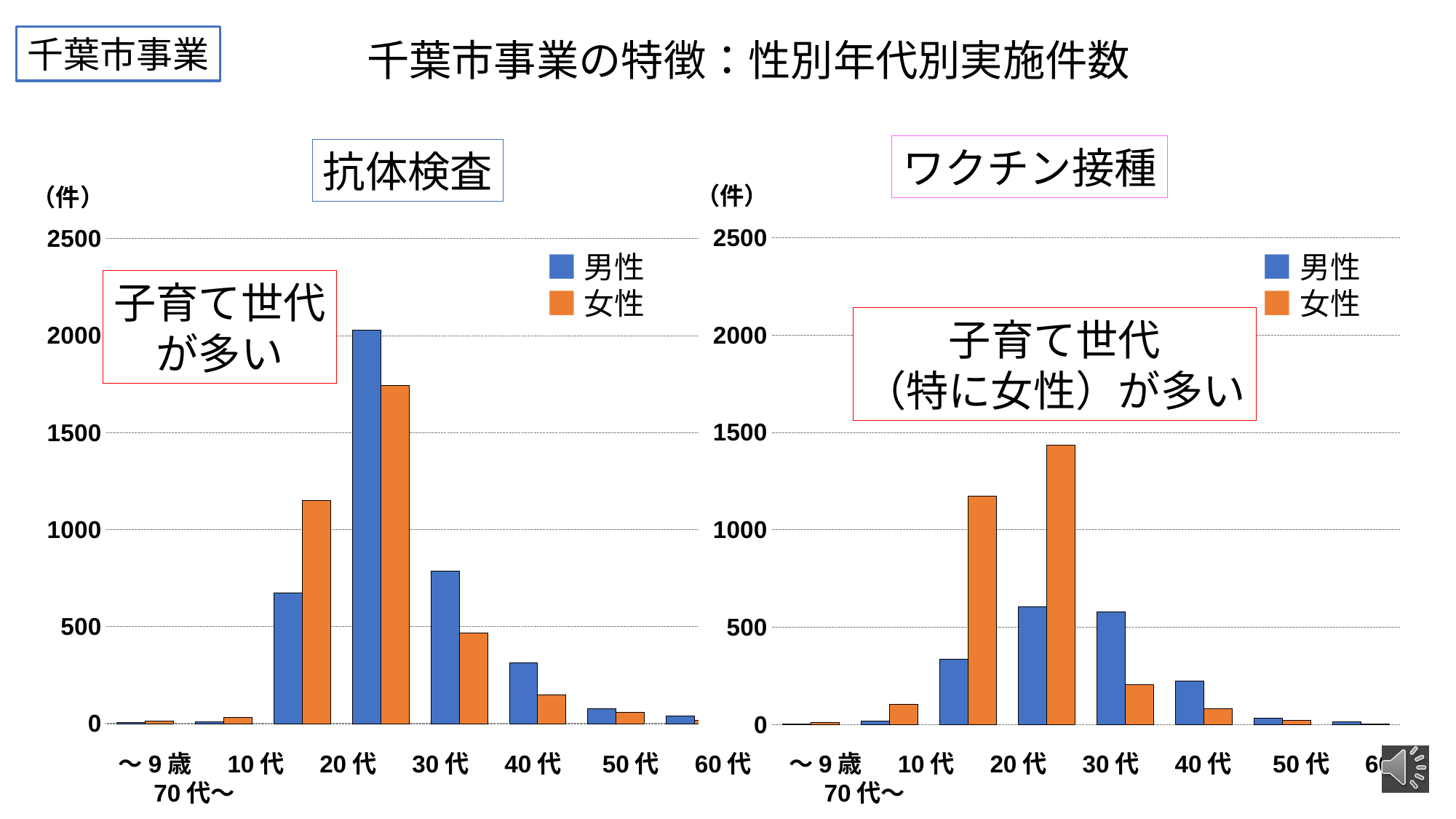
What kind of chart is the 抗体検査 chart? bar chart In the 抗体検査 chart, is the value for 女性 in 10代 greater or less than 1000? less In the ワクチン接種 chart, which age group has the highest value for 女性? 30代 In the 抗体検査 chart, is the value for 男性 in 20代 greater or less than 1500? less In the 抗体検査 chart, which is larger for 30代: 男性 or 女性? 男性 In the ワクチン接種 chart, which is larger for 20代: 男性 or 女性? 女性 In the ワクチン接種 chart, what colour represents 女性? orange How many series does the legend of the ワクチン接種 chart list? 2 In the 抗体検査 chart, which is larger for 10代: 男性 or 女性? 女性 In the ワクチン接種 chart, is the value for 女性 in 20代 greater or less than 1500? less In the 抗体検査 chart, which age group has the highest value for 男性? 30代